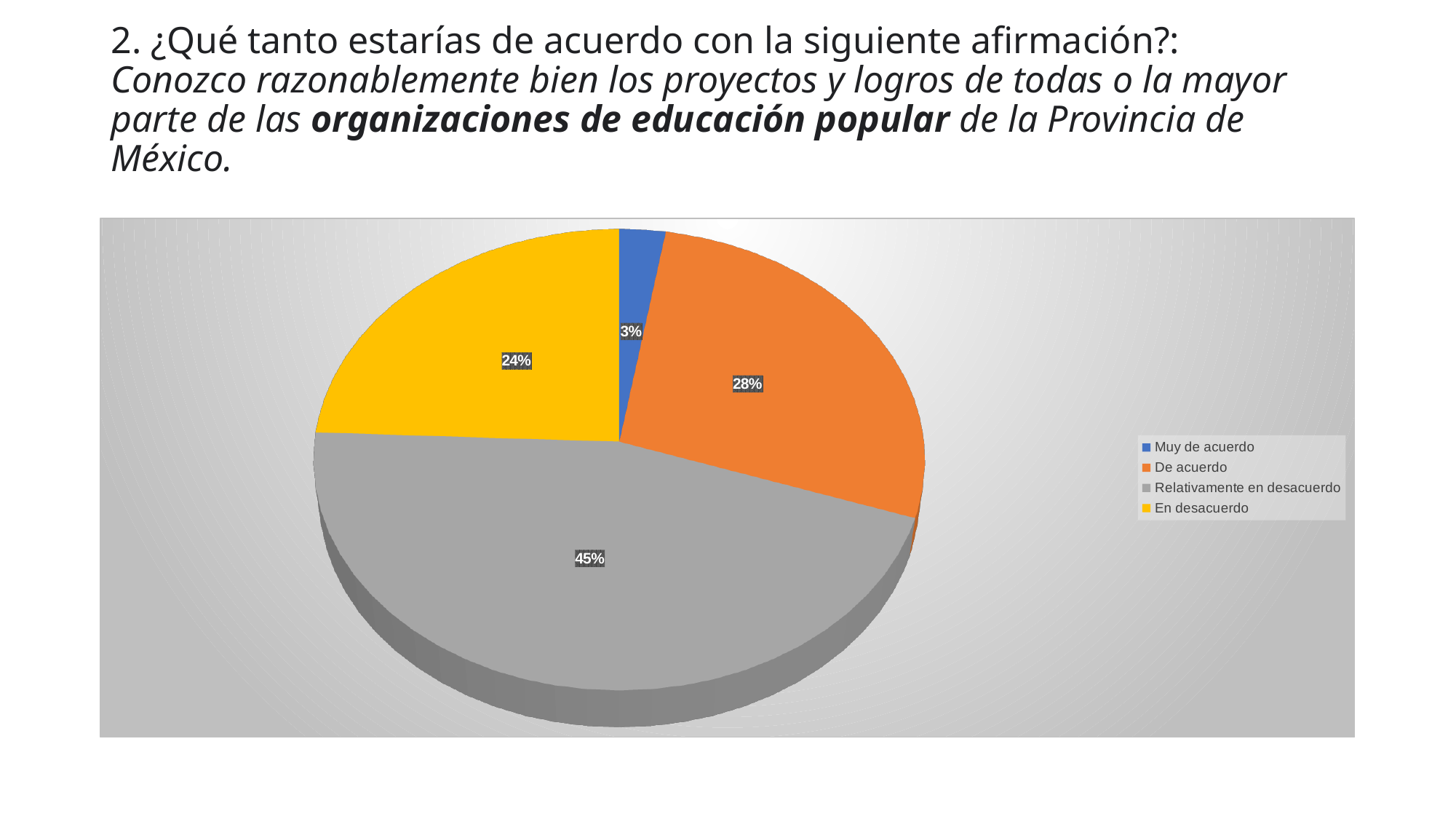
What percentage of respondents answered "Muy de acuerdo"? 3% What is the combined percentage of "Muy de acuerdo" and "De acuerdo"? 31% What colour is the slice for "En desacuerdo"? Yellow Which is larger, the share for "De acuerdo" or the share for "En desacuerdo"? De acuerdo What kind of chart is shown on the slide? Pie chart Which response category has the smallest share of the pie? Muy de acuerdo What percentage of respondents answered "De acuerdo"? 28% What percentage of respondents answered "Relativamente en desacuerdo"? 45% What is the difference in percentage points between "Relativamente en desacuerdo" and "De acuerdo"? 17 Which response category has the largest share of the pie? Relativamente en desacuerdo How many categories does the pie chart have? 4 What percentage of respondents answered "En desacuerdo"? 24%